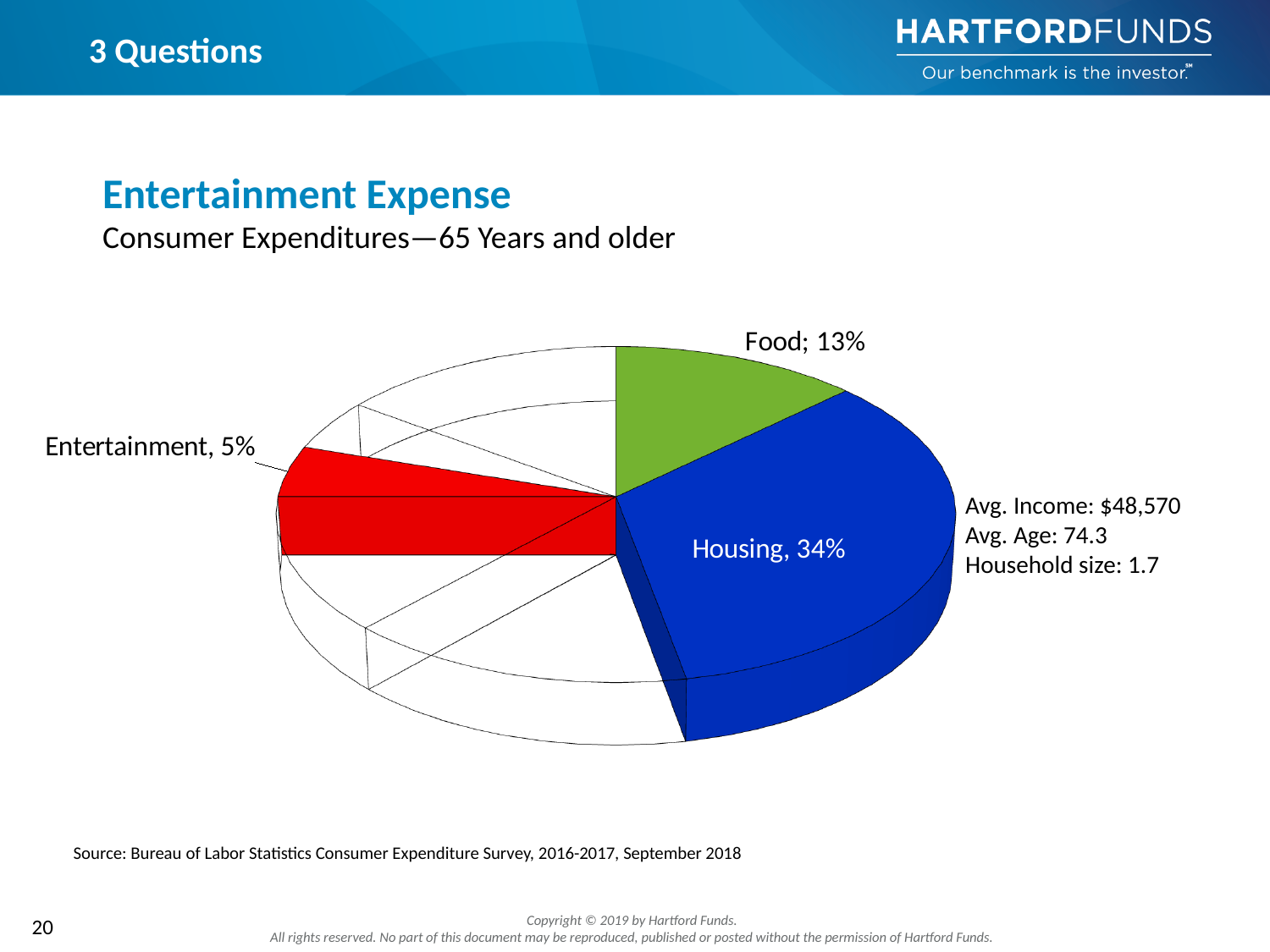
Of the labeled slices in the pie chart, which category has the largest share? Housing How many percentage points larger is the Housing share than the Food share in the pie chart? 21 percentage points What share of the pie chart is labeled Food? 13% How many percentage points larger is the Food share than the Entertainment share? 8 percentage points What type of chart is shown on the slide? Pie chart What colour is the Entertainment slice in the pie chart? Red Which is larger in the pie chart, the Food share or the Entertainment share? Food What percentage is shown for Entertainment in the pie chart? 5% What percentage of consumer expenditures does Housing account for in the pie chart? 34% Of the labeled slices in the pie chart, which category has the smallest share? Entertainment What colour is the Housing slice in the pie chart? Blue